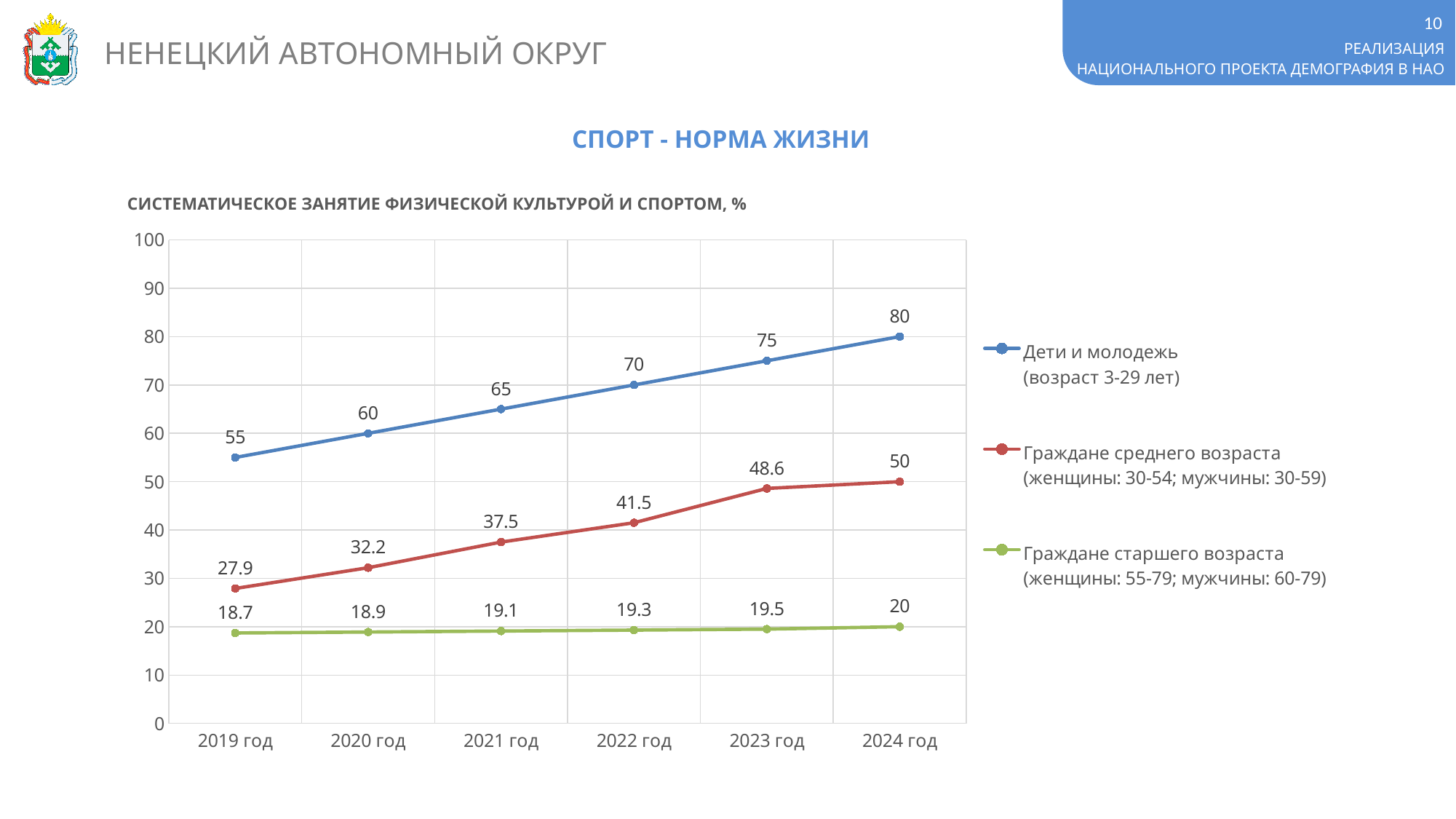
In which year is the value for "Граждане среднего возраста" lowest? 2019 год What is the value for "Дети и молодежь (возраст 3-29 лет)" in 2021 год? 65 Do the values for "Граждане старшего возраста" rise or fall from 2019 год to 2024 год? rise In which year is the value for "Дети и молодежь" highest? 2024 год What kind of chart is shown on the slide? line chart Which is larger in 2020 год: the value for "Граждане среднего возраста" or for "Граждане старшего возраста"? Граждане среднего возраста What is the value for "Граждане среднего возраста" in 2023 год? 48.6 How many years are shown on the x axis? 6 What is the difference between the 2022 год and 2021 год values for "Граждане среднего возраста"? 4 What is the value for "Граждане старшего возраста" in 2019 год? 18.7 How many series does the legend list? 3 What is the difference between the 2024 год and 2019 год values for "Дети и молодежь"? 25